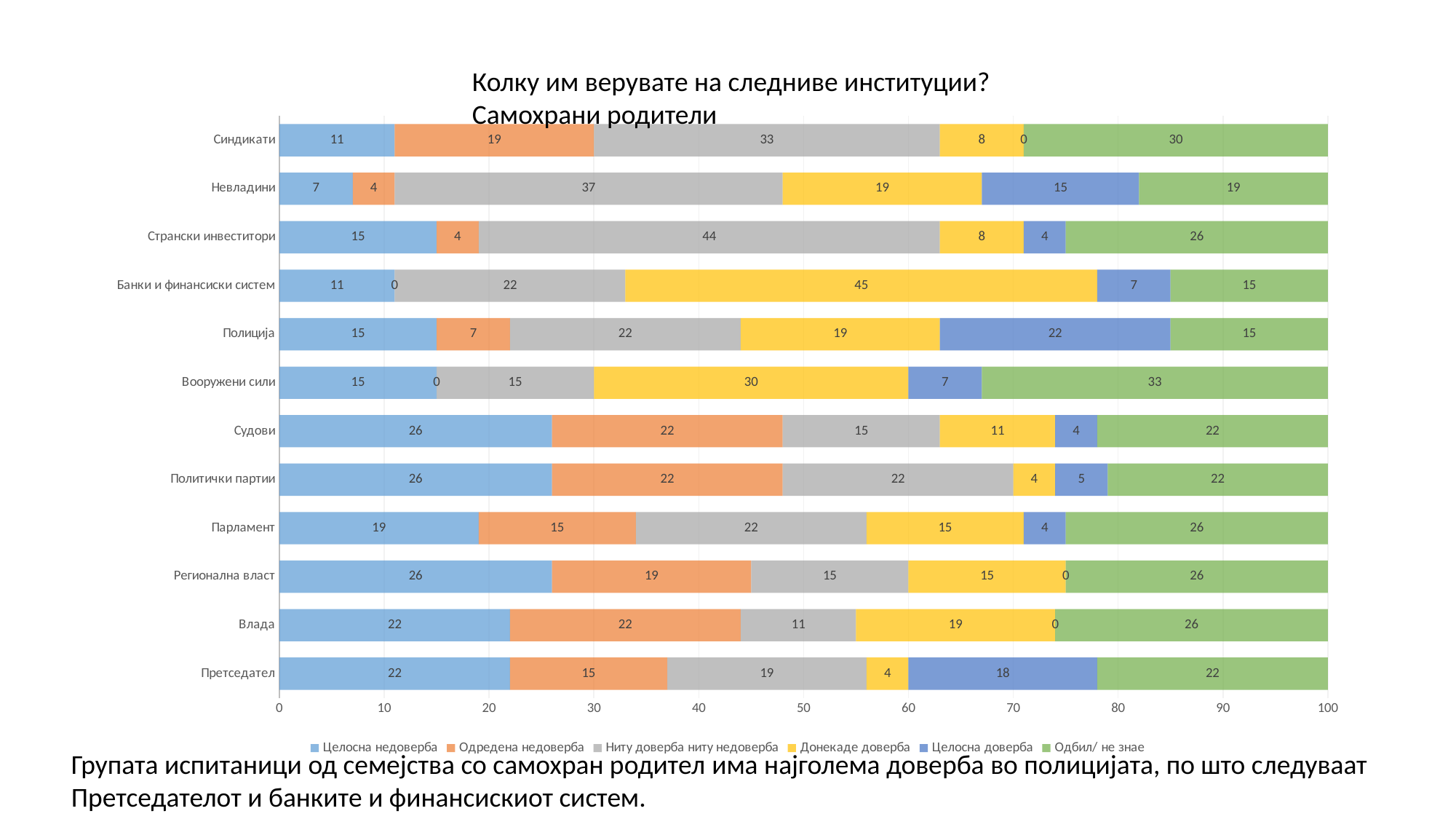
What is the value of 'Ниту доверба ниту недоверба' for Невладини? 37 What is the title of the chart? Колку им верувате на следниве институции? Самохрани родители What is the value of 'Целосна доверба' for Полиција? 22 What type of chart is shown on the slide? Stacked bar chart What is the value of 'Донекаде доверба' for Банки и финансиски систем? 45 What is the difference between the 'Целосна доверба' values for Претседател and Странски инвеститори? 14 How many series does the legend list? 6 How many institutions (categories) are listed on the chart? 12 Which is larger: the 'Одбил/ не знае' value for Вооружени сили or for Синдикати? Вооружени сили What is the total of the stacked bar for Полиција? 100 Which institution has the lowest value for 'Целосна недоверба'? Невладини Which institution has the highest value for 'Целосна доверба'? Полиција